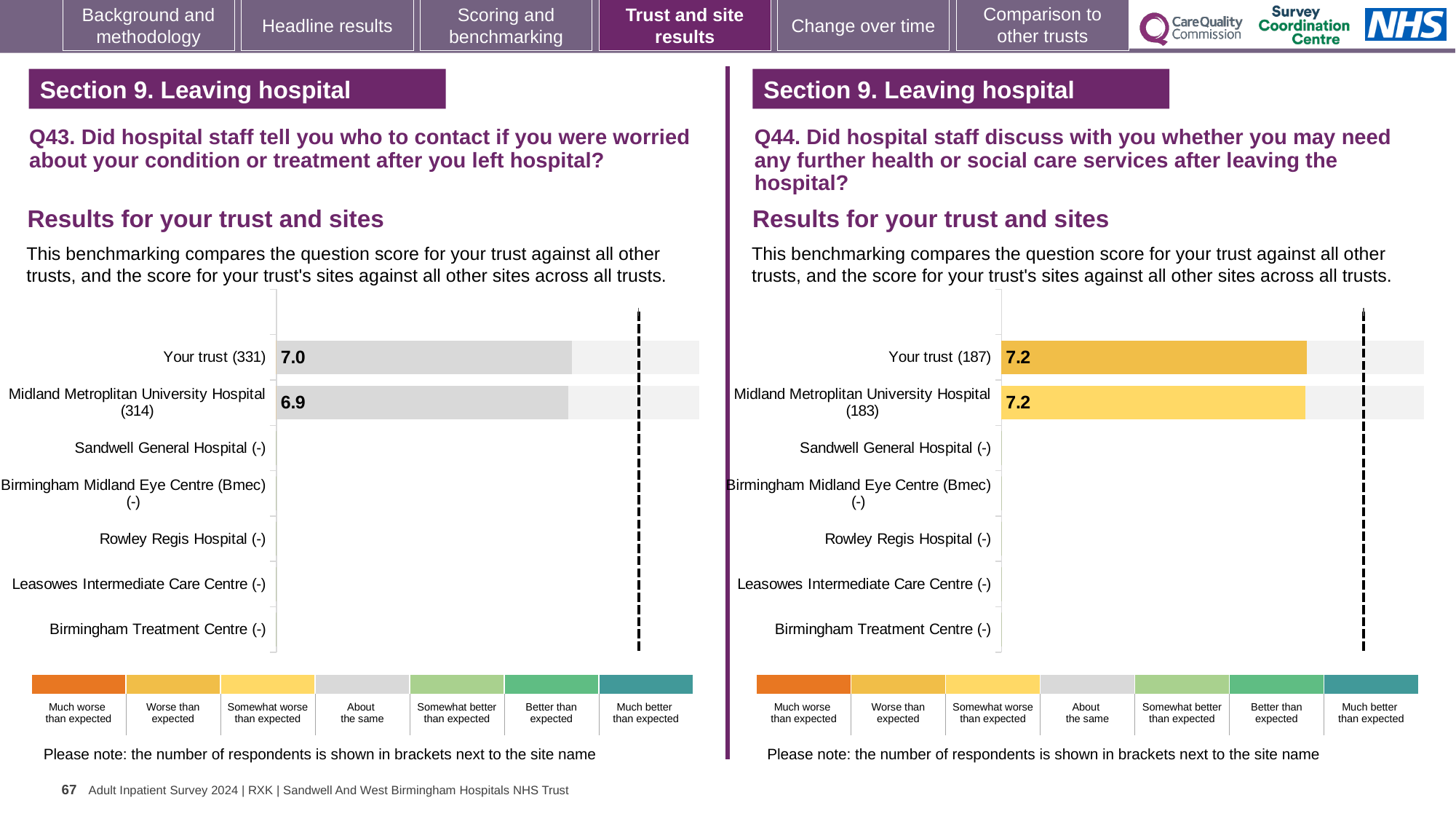
On the Q43 chart (left), which has the higher score: Your trust or Midland Metropolitan University Hospital? Your trust On the Q44 chart (right), how many respondents are shown in brackets for Midland Metropolitan University Hospital? 183 On the Q44 chart (right), what is the score for Your trust? 7.2 On the Q43 chart (left), what is the score for Midland Metropolitan University Hospital? 6.9 On the Q43 chart (left), what is the score for Your trust? 7.0 On the Q43 chart (left), what is the difference between the score for Your trust and the score for Midland Metropolitan University Hospital? 0.1 What type of chart is used on the Q43 chart (left)? Bar chart How many site/trust categories are listed on the Q44 chart (right)? 7 On the Q44 chart (right), which benchmark category does the colour of the Your trust bar correspond to in the legend? Worse than expected On the Q43 chart (left), which benchmark category does the colour of the Your trust bar correspond to in the legend? About the same On the Q44 chart (right), what is the score for Midland Metropolitan University Hospital? 7.2 On the Q43 chart (left), how many respondents are shown in brackets for Your trust? 331